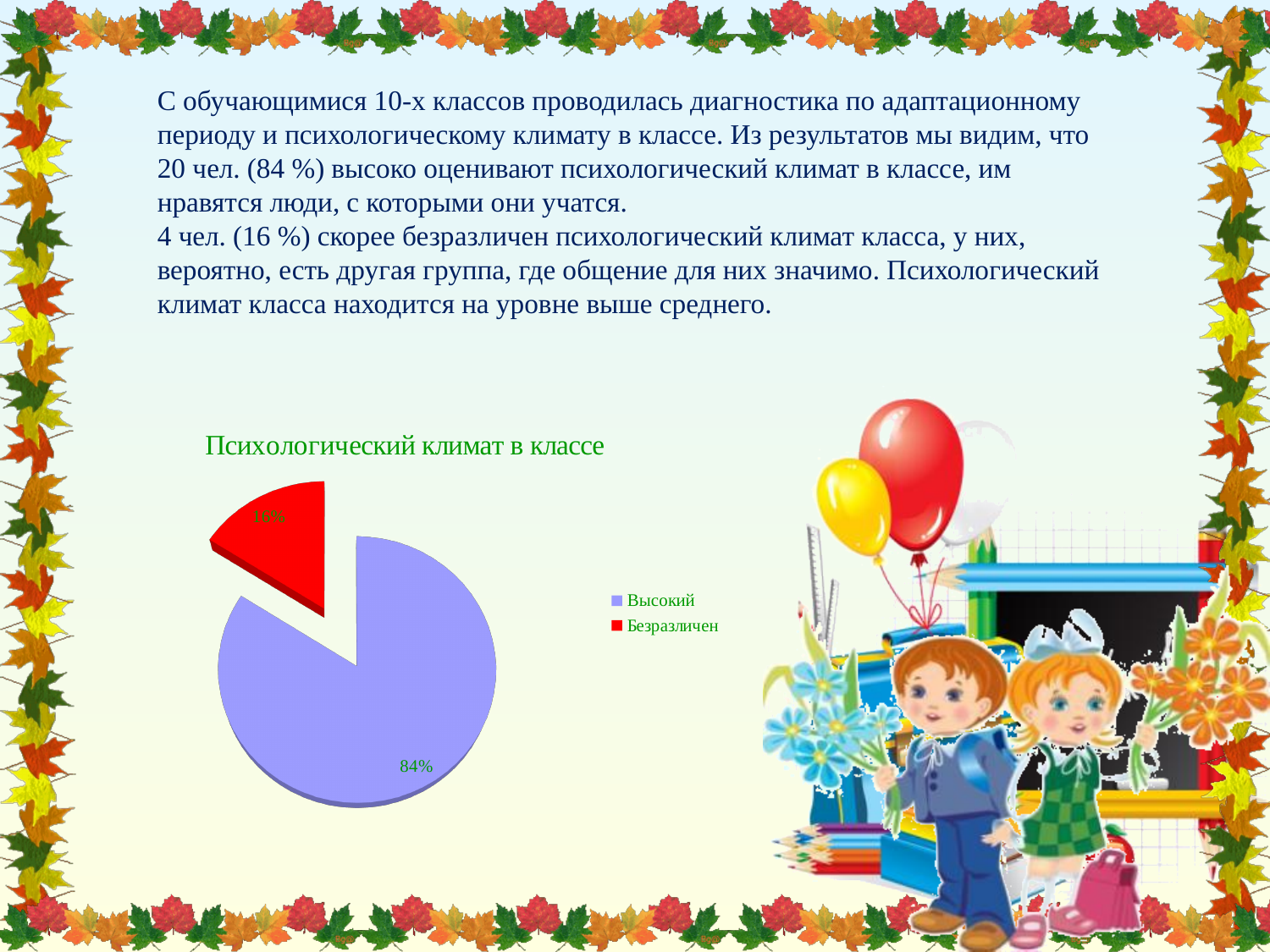
Which category has the largest slice of the pie? Высокий Which category has the smallest slice of the pie? Безразличен What share of the pie does the "Высокий" slice represent? 84% How many entries does the legend list? 2 What share of the pie does the "Безразличен" slice represent? 16% What colour is the "Безразличен" slice? red Which is larger, the "Высокий" slice or the "Безразличен" slice? Высокий What is the difference between the "Высокий" and "Безразличен" shares? 68% What kind of chart is shown on the slide? pie chart How many categories does the pie chart show? 2 What is the title of the chart? Психологический климат в классе